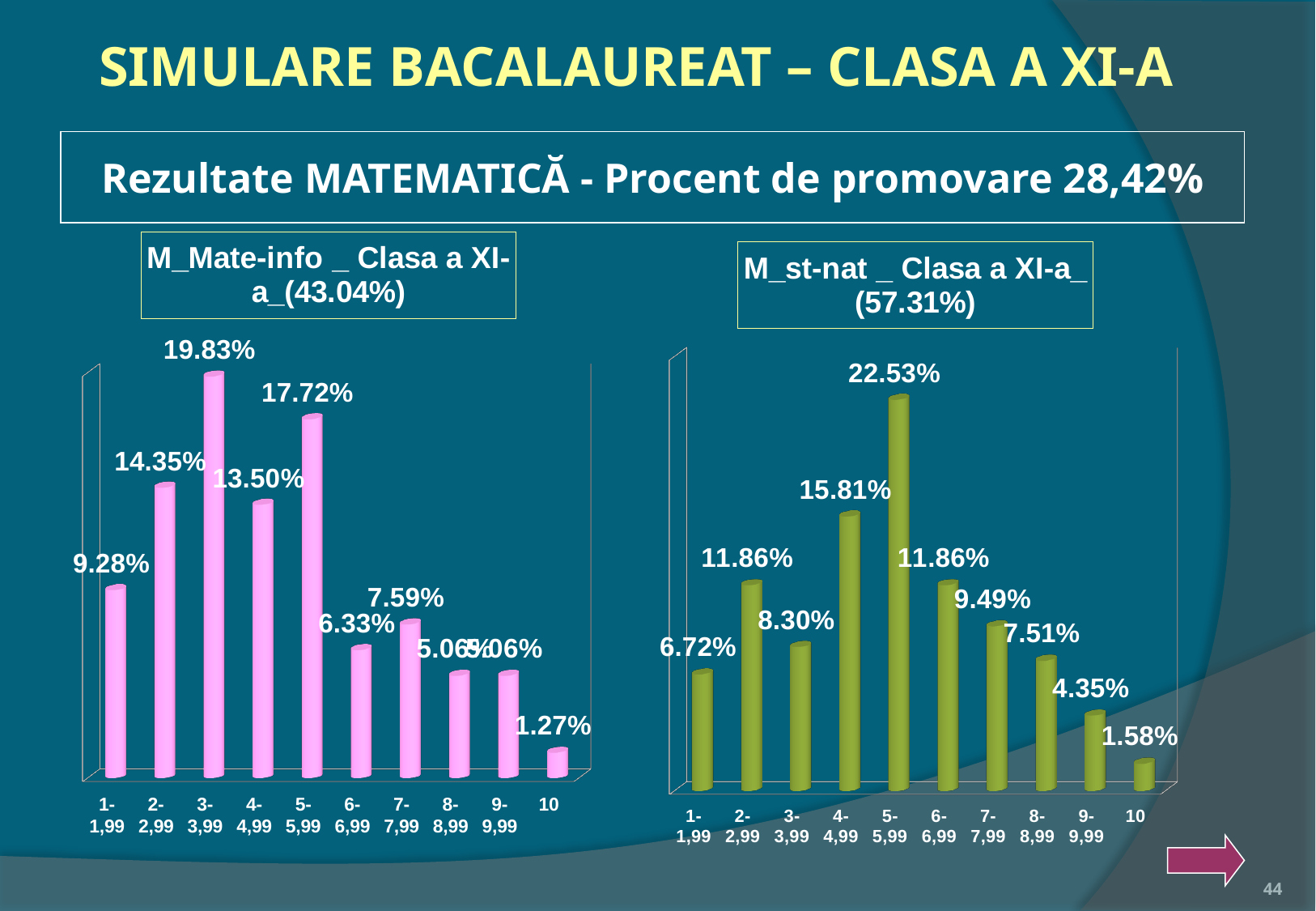
What colour are the bars in the M_st-nat chart on the right? Green In the M_Mate-info chart on the left, what is the difference between the values for 5-5,99 and 4-4,99? 4.22% In the M_st-nat chart on the right, what is the value for the 5-5,99 category? 22.53% How many categories are shown in the M_st-nat chart on the right? 10 What kind of chart is the M_Mate-info chart on the left? Bar chart In the M_Mate-info chart on the left, which is larger: the value for 1-1,99 or the value for 6-6,99? 1-1,99 In the M_st-nat chart on the right, which category has the lowest value? 10 In the M_st-nat chart on the right, what is the difference between the values for 4-4,99 and 3-3,99? 7.51% In the M_Mate-info chart on the left, what is the value for the 10 category? 1.27% In the M_Mate-info chart on the left, which category has the highest value? 3-3,99 In the M_st-nat chart on the right, which is larger: the value for 2-2,99 or the value for 7-7,99? 2-2,99 In the M_Mate-info chart on the left, what is the value for the 3-3,99 category? 19.83%